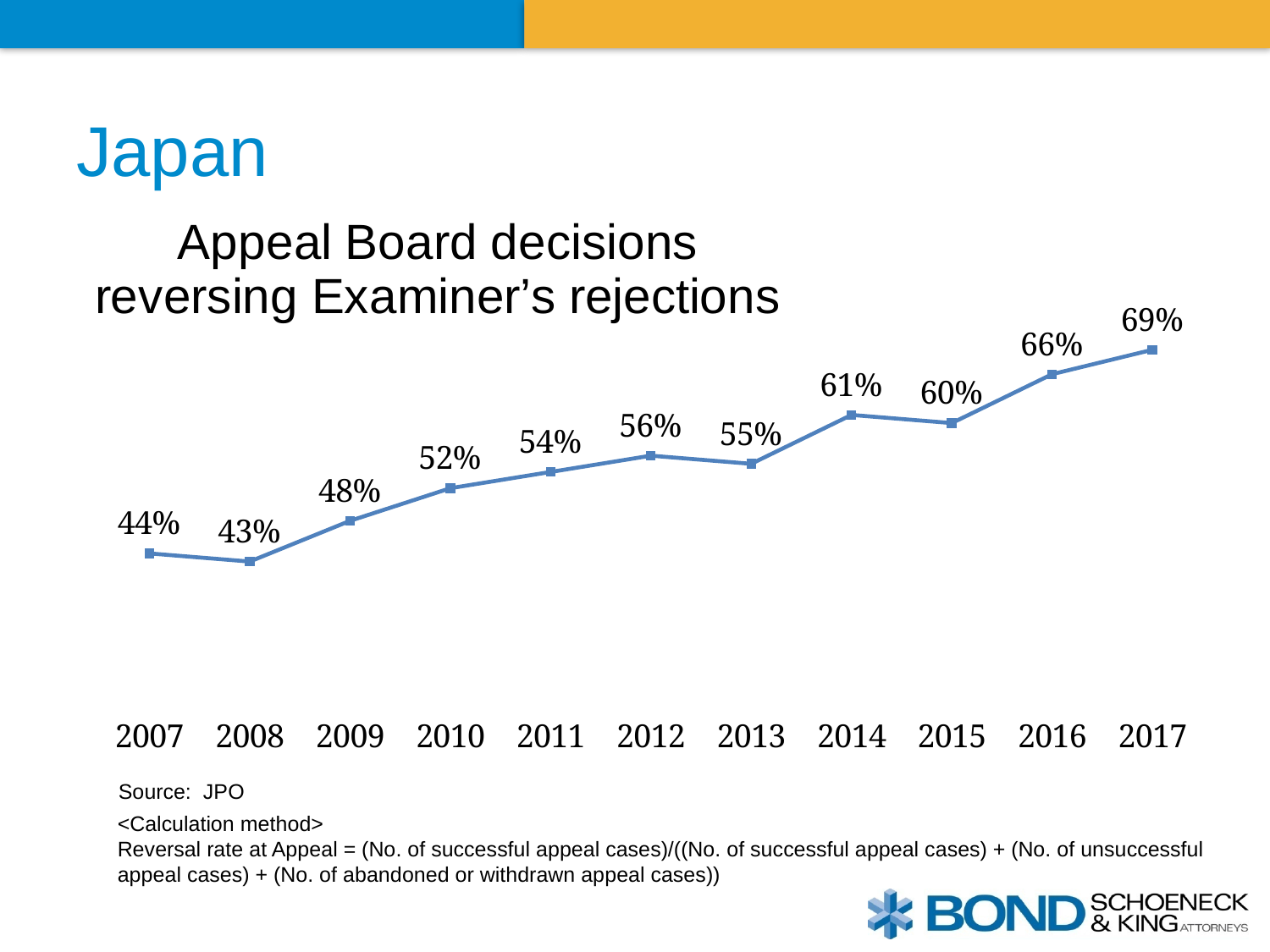
What is the difference between the reversal rate in 2014 and in 2015? 1% What is the difference between the reversal rate in 2017 and in 2007? 25% What is the overall trend of the reversal rate from 2007 to 2017? rising Which year has the highest reversal rate? 2017 Which year has the lowest reversal rate? 2008 What was the reversal rate in 2017? 69% What is the source of the data cited on the slide? JPO How many years are plotted on the chart? 11 What was the reversal rate in 2007? 44% What type of chart is shown on the slide? line chart Which year has a higher reversal rate, 2013 or 2014? 2014 What was the reversal rate in 2012? 56%